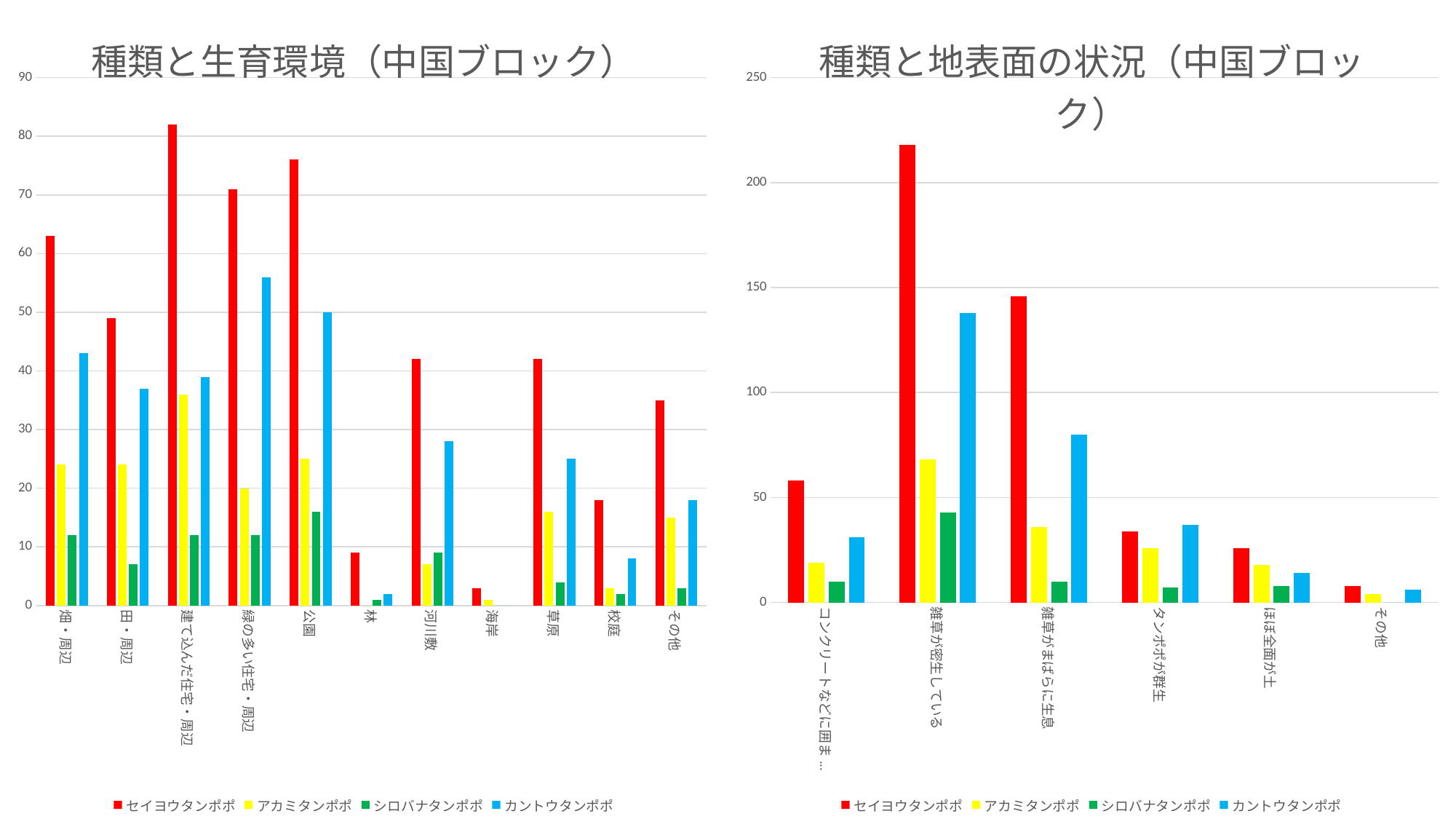
In the left chart 種類と生育環境（中国ブロック）, which category has the highest value for セイヨウタンポポ? 建て込んだ住宅・周辺 In the right chart 種類と地表面の状況（中国ブロック）, how many series does the legend list? 4 In the left chart 種類と生育環境（中国ブロック）, is the value of セイヨウタンポポ for 公園 greater or less than 70? greater In the right chart 種類と地表面の状況（中国ブロック）, which colour represents シロバナタンポポ in the legend? green In the left chart 種類と生育環境（中国ブロック）, how many categories are shown on the x axis? 11 In the left chart 種類と生育環境（中国ブロック）, is the value of カントウタンポポ for 緑の多い住宅・周辺 greater or less than 50? greater In the right chart 種類と地表面の状況（中国ブロック）, which is larger, the カントウタンポポ value for 雑草が密生している or for コンクリートなどに囲ま…? 雑草が密生している In the left chart 種類と生育環境（中国ブロック）, which category has the lowest value for セイヨウタンポポ? 海岸 In the right chart 種類と地表面の状況（中国ブロック）, which category has the highest value for セイヨウタンポポ? 雑草が密生している In the right chart 種類と地表面の状況（中国ブロック）, is the value of セイヨウタンポポ for 雑草が密生している greater or less than 200? greater What kind of chart is the left chart titled 種類と生育環境（中国ブロック）? bar chart In the left chart 種類と生育環境（中国ブロック）, which is larger, the セイヨウタンポポ value for 公園 or for 林? 公園